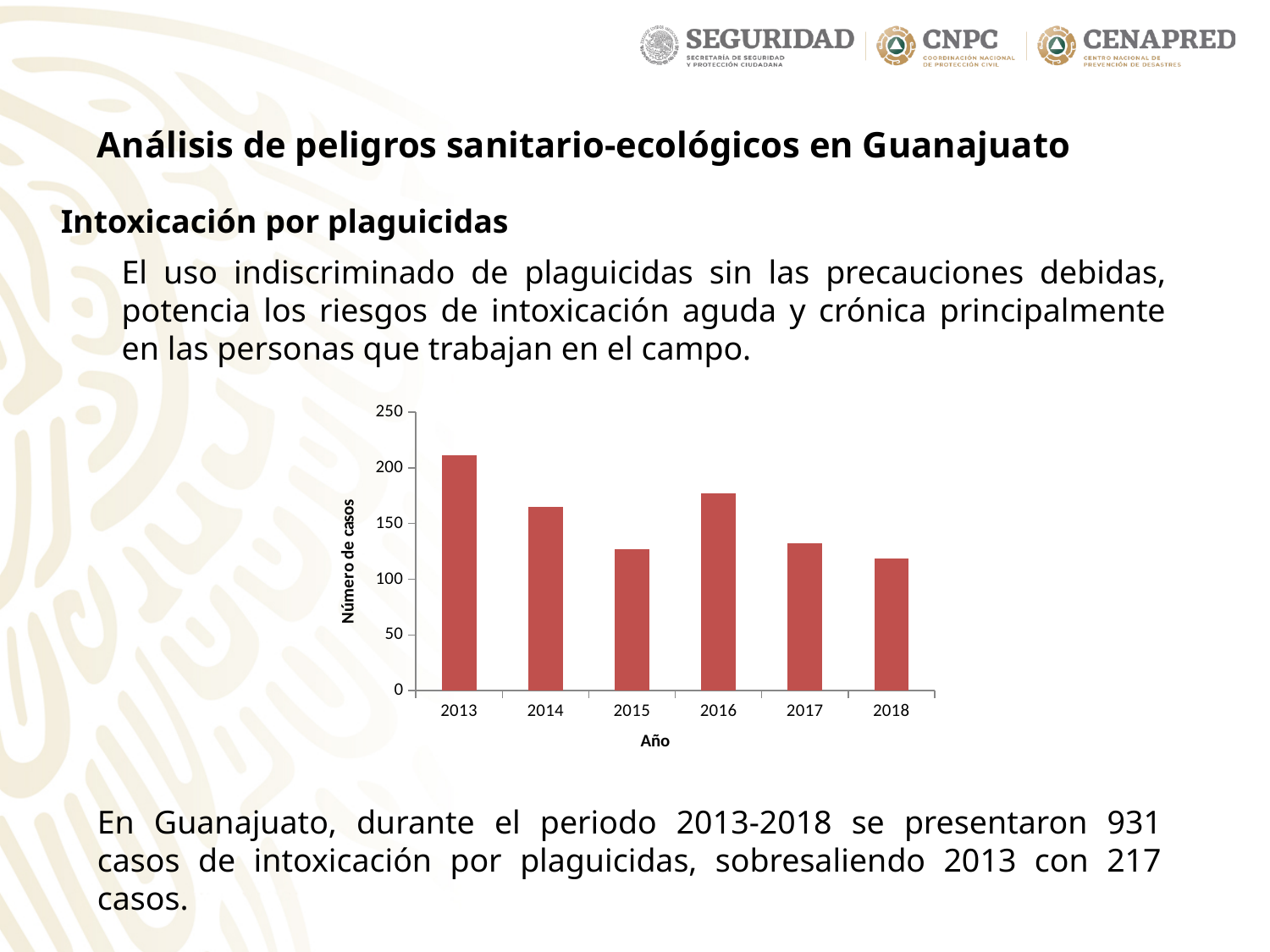
Is the value for 2016 greater or less than 150? greater Is the value for 2015 greater or less than 150? less Which year has the highest number of cases in the chart? 2013 Which year has the lowest number of cases in the chart? 2018 Which year has more cases, 2014 or 2015? 2014 How many years are shown on the x axis of the chart? 6 What is the title of the vertical axis of the chart? Número de casos Is the value for 2013 greater or less than 200? greater Which year has more cases, 2016 or 2017? 2016 What kind of chart is shown on the slide? bar chart Do the values rise or fall from 2016 to 2018? fall